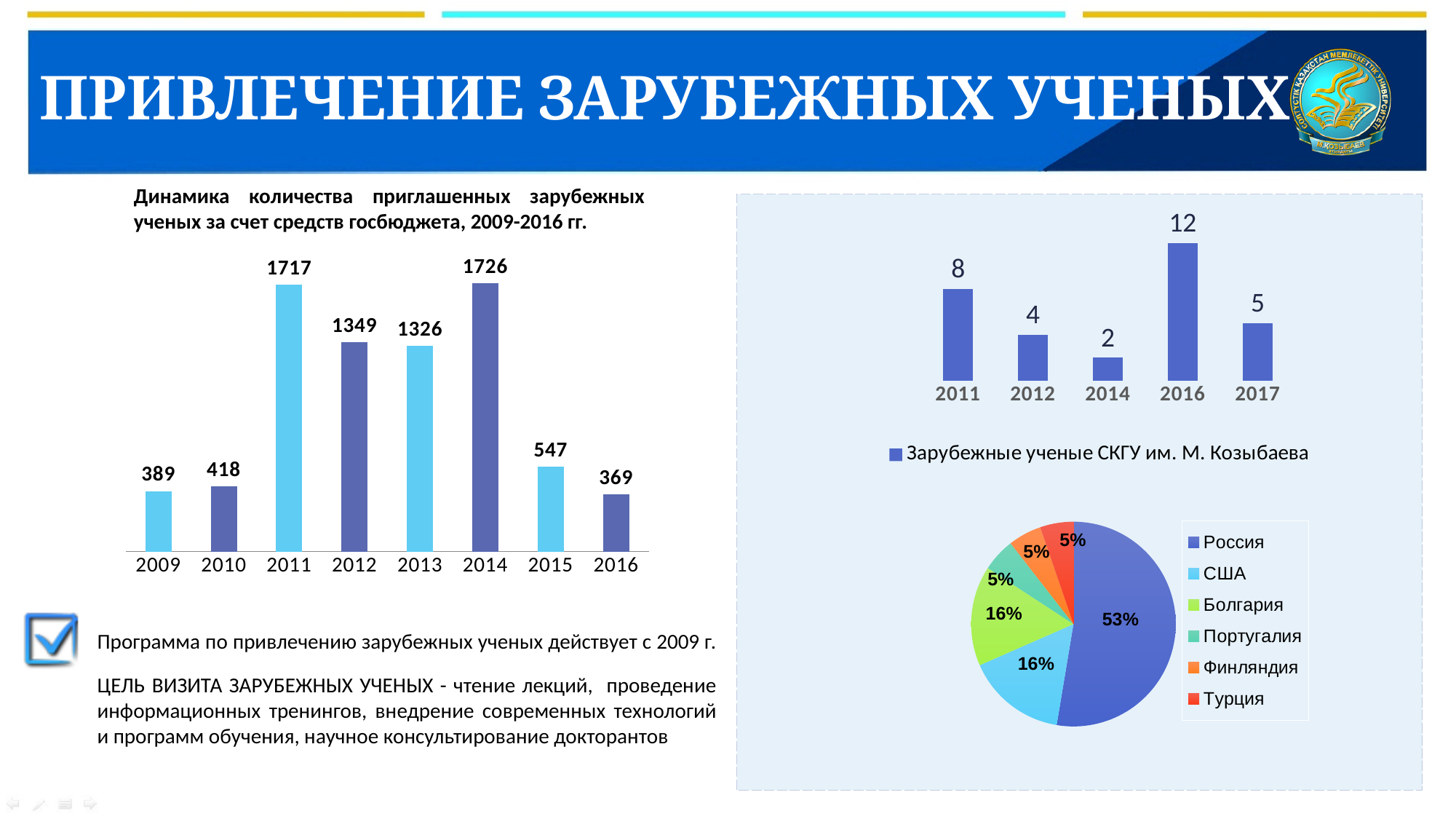
In the top-right bar chart (Зарубежные ученые СКГУ им. М. Козыбаева), what is the value for 2016? 12 In the left bar chart on the dynamics of invited foreign scientists 2009-2016, what is the difference between the values for 2014 and 2015? 1179 In the left bar chart on the dynamics of invited foreign scientists 2009-2016, what is the value for 2011? 1717 How many entries does the legend of the bottom-right pie chart list? 6 In the top-right bar chart (Зарубежные ученые СКГУ им. М. Козыбаева), which year has the lowest value? 2014 In the left bar chart on the dynamics of invited foreign scientists 2009-2016, how many years are shown on the x axis? 8 What type of chart is the bottom-right chart showing countries such as Россия and США? pie chart In the bottom-right pie chart, what share does Россия have? 53% In the top-right bar chart (Зарубежные ученые СКГУ им. М. Козыбаева), what is the difference between the values for 2011 and 2017? 3 In the left bar chart on the dynamics of invited foreign scientists 2009-2016, which year has the highest value? 2014 In the left bar chart on the dynamics of invited foreign scientists 2009-2016, which year has the lowest value? 2016 In the left bar chart on the dynamics of invited foreign scientists 2009-2016, is the value for 2012 larger or smaller than the value for 2013? larger